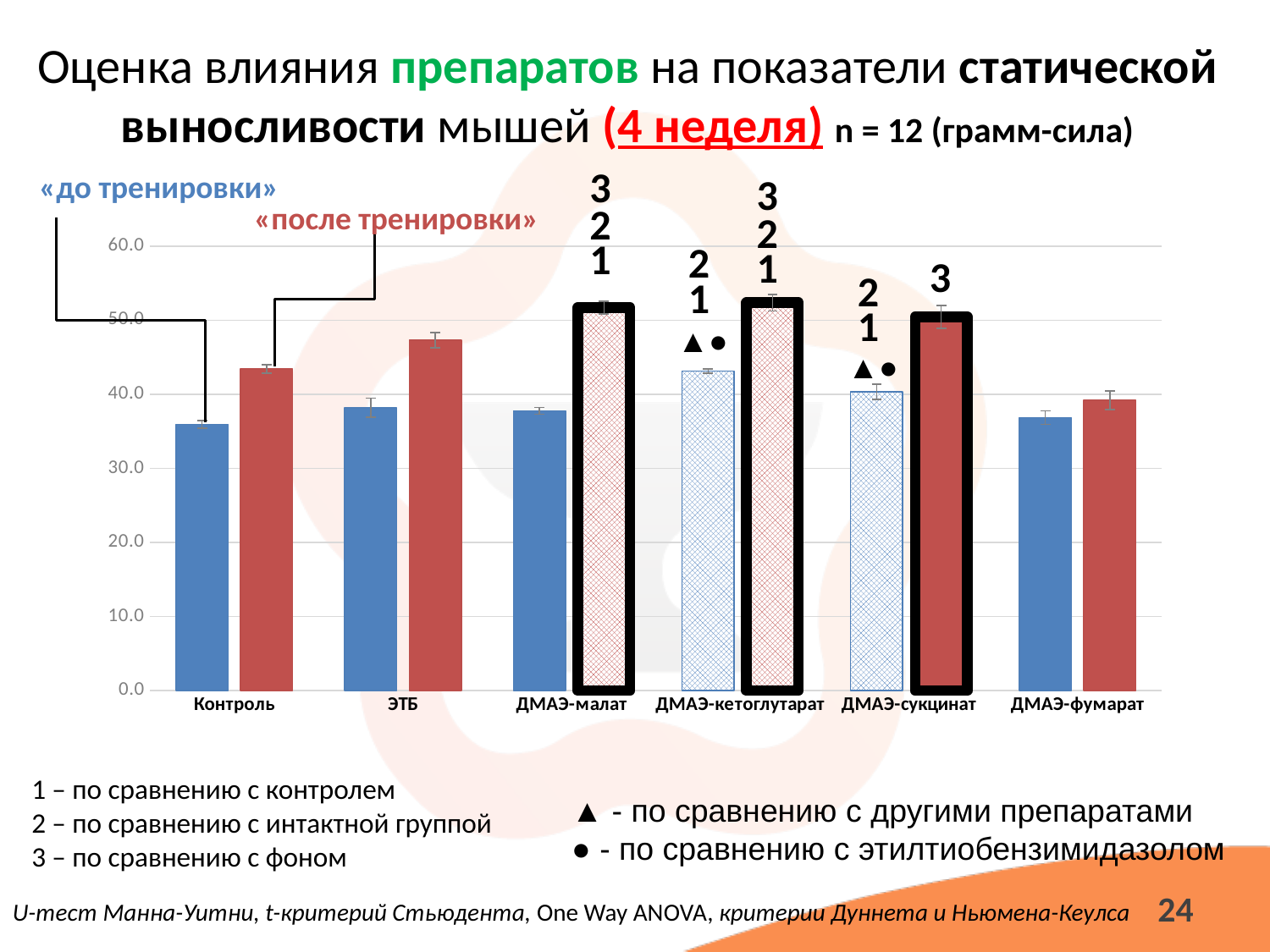
Which is larger: the «после тренировки» value for Контроль or for ЭТБ? ЭТБ How many series does the chart show? 2 Is the «после тренировки» value for ЭТБ greater or less than 50.0? less Is the «после тренировки» value for Контроль greater or less than 40.0? greater Which category has the lowest «после тренировки» value? ДМАЭ-фумарат Is the «до тренировки» value for Контроль greater or less than 40.0? less What are the two series shown in the chart? «до тренировки» and «после тренировки» How many categories (groups) are shown on the x axis of the chart? 6 Which category has the highest «до тренировки» value? ДМАЭ-кетоглутарат What kind of chart is shown on the slide? bar chart